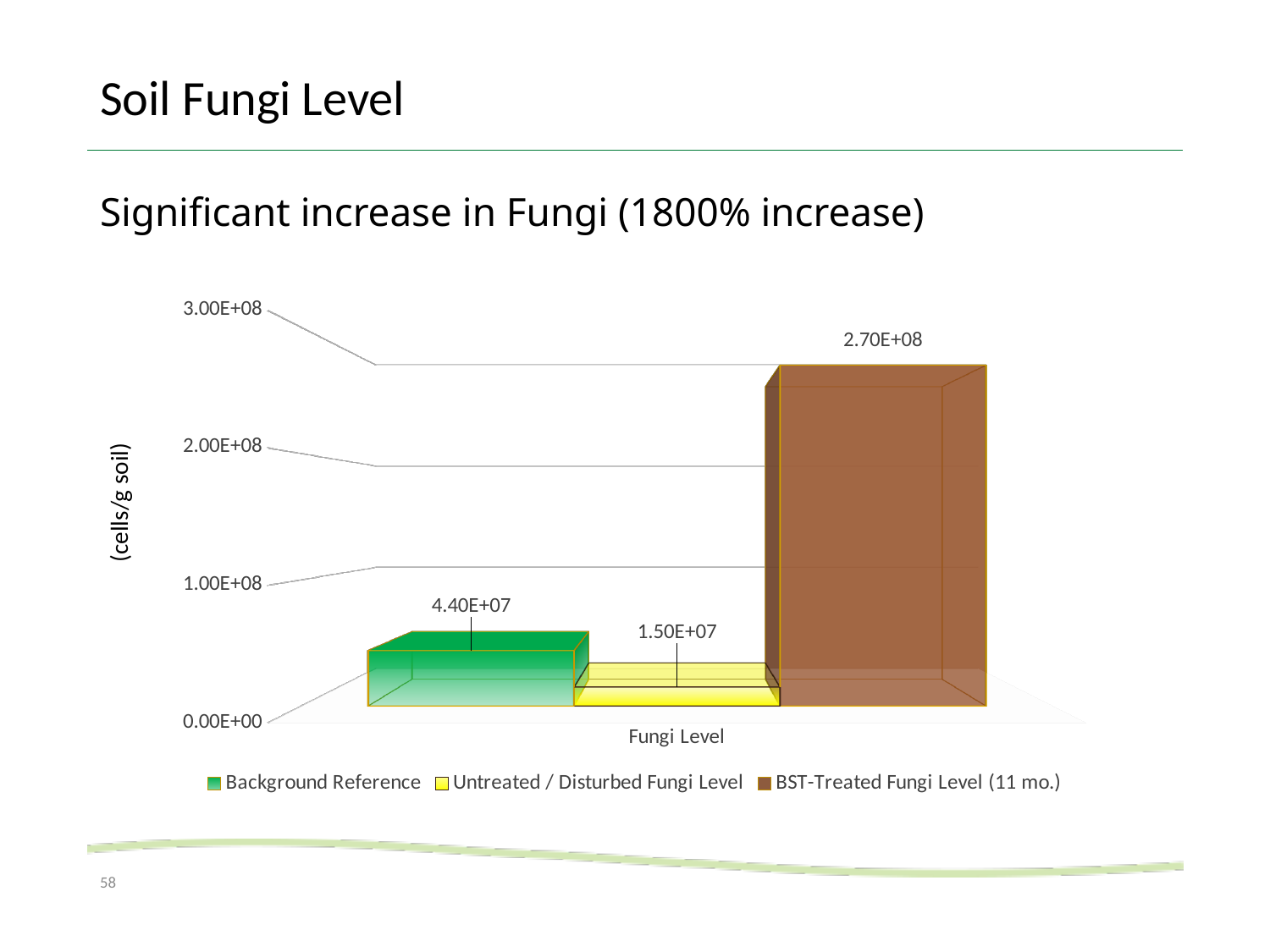
Is the value for BST-Treated Fungi Level (11 mo.) greater or less than 2.00E+08? greater How many series does the legend list? 3 What is the value for BST-Treated Fungi Level (11 mo.)? 2.70E+08 What is the difference between the Background Reference value and the Untreated / Disturbed Fungi Level value? 2.90E+07 What is the value for Background Reference? 4.40E+07 What is the difference between the BST-Treated Fungi Level (11 mo.) value and the Background Reference value? 2.26E+08 Which series has the lowest value? Untreated / Disturbed Fungi Level Which series has the highest value? BST-Treated Fungi Level (11 mo.) What kind of chart is shown on the slide? bar chart What unit is shown on the vertical axis label? (cells/g soil) Which is larger, the Background Reference value or the Untreated / Disturbed Fungi Level value? Background Reference What is the value for Untreated / Disturbed Fungi Level? 1.50E+07